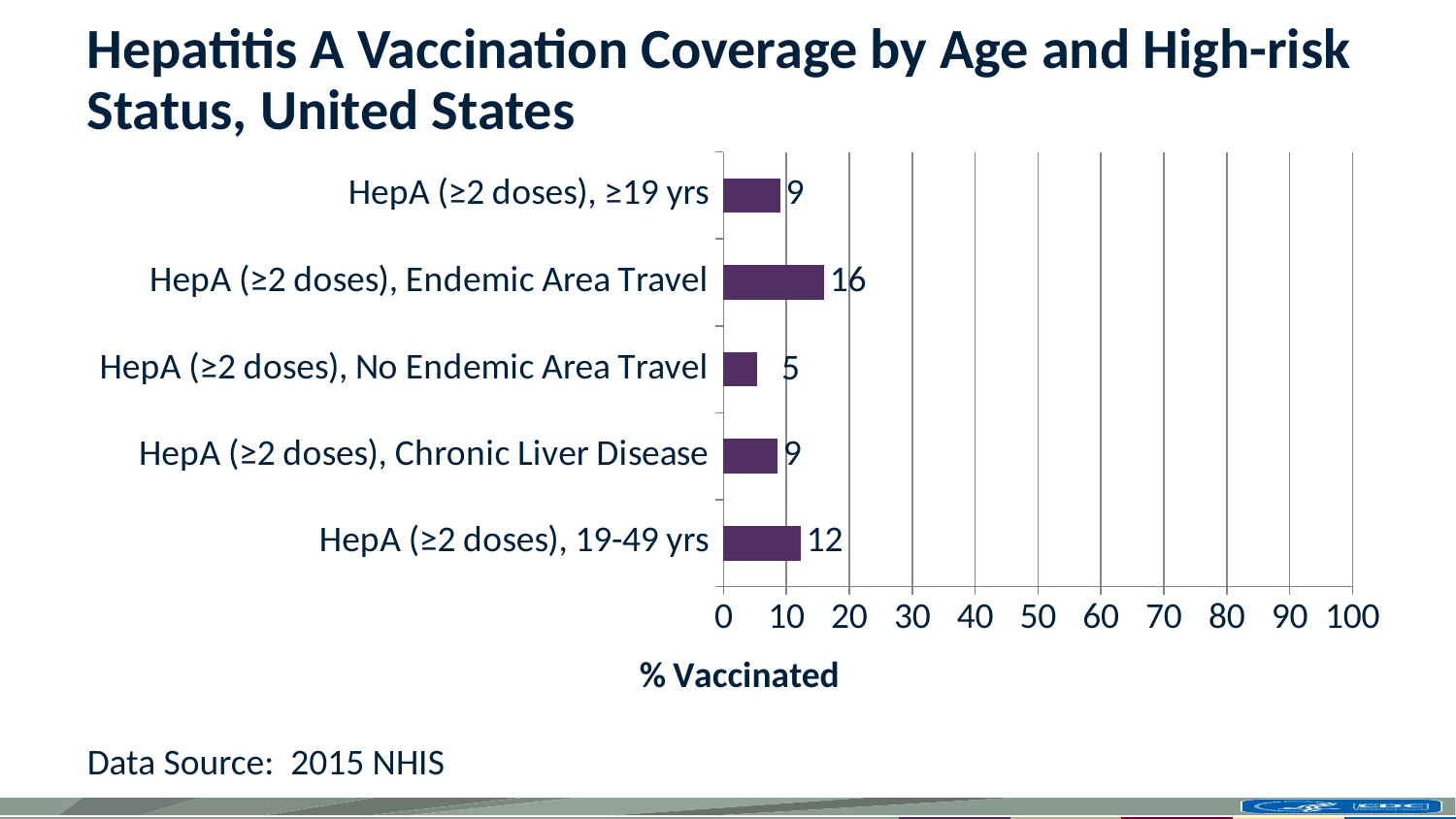
What is the difference between the values for Endemic Area Travel and No Endemic Area Travel? 11 Which is larger, the value for 19-49 yrs or the value for Chronic Liver Disease? 19-49 yrs Which category has the highest value? HepA (≥2 doses), Endemic Area Travel What is the label of the horizontal axis? % Vaccinated Which category has the lowest value? HepA (≥2 doses), No Endemic Area Travel What is the value for HepA (≥2 doses), 19-49 yrs? 12 How many categories are shown in the chart? 5 Is the value for HepA (≥2 doses), Endemic Area Travel greater or less than 20? less What kind of chart is shown on the slide? bar chart What is the value for HepA (≥2 doses), ≥19 yrs? 9 What is the value for HepA (≥2 doses), Endemic Area Travel? 16 What is the value for HepA (≥2 doses), No Endemic Area Travel? 5